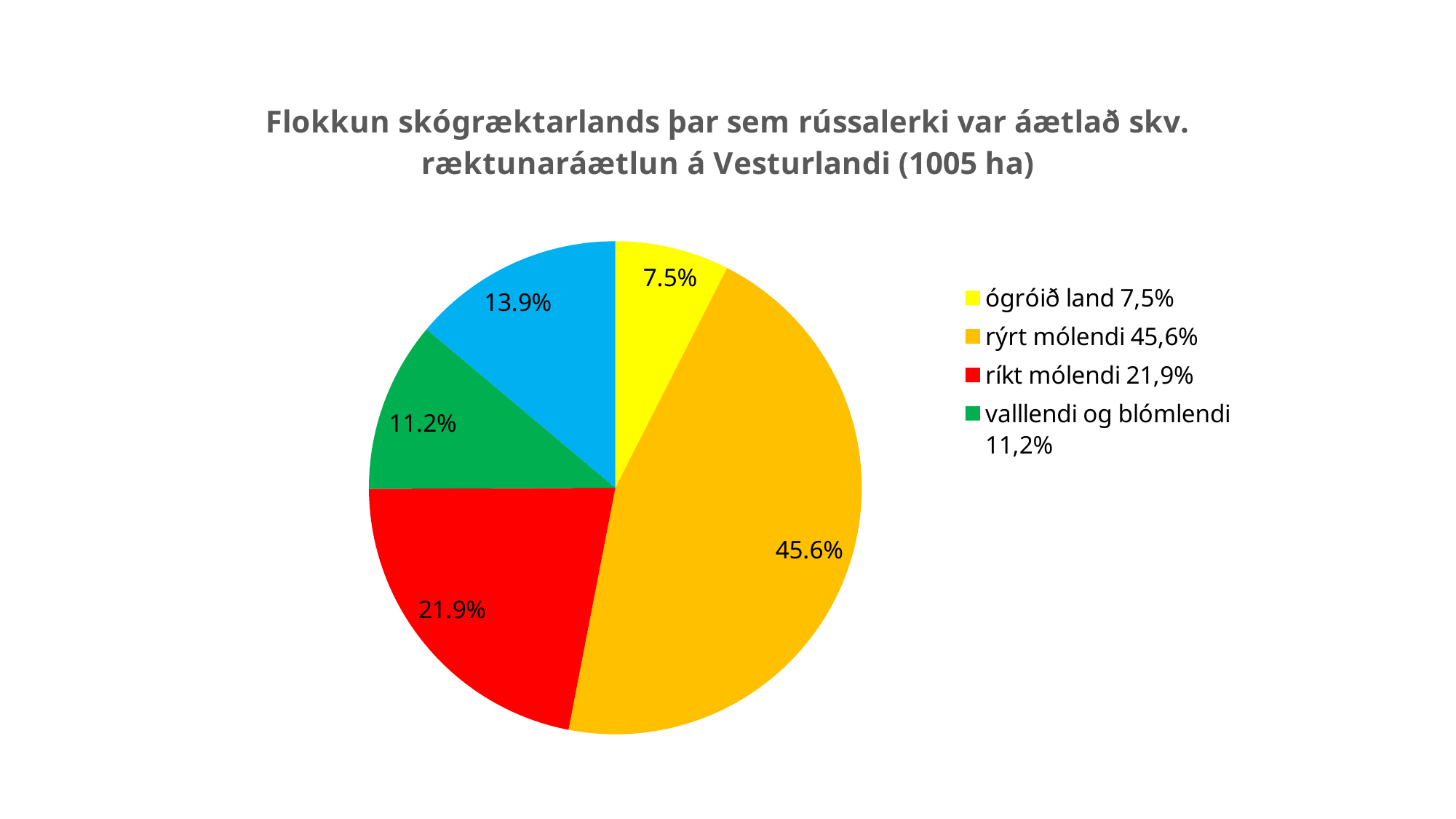
What share of the pie does "ríkt mólendi" have? 21.9% What is the difference in percentage points between "rýrt mólendi" and "ríkt mólendi"? 23.7 How many entries does the legend list? 4 What share of the pie does "rýrt mólendi" have? 45.6% Which is larger, the slice for "ríkt mólendi" or the slice for "valllendi og blómlendi"? ríkt mólendi What kind of chart is shown on the slide? pie chart What share of the pie does "valllendi og blómlendi" have? 11.2% What share of the pie does "ógróið land" have? 7.5% Which category has the largest slice of the pie? rýrt mólendi Which category has the smallest slice of the pie? ógróið land How many slices does the pie chart have? 5 What colour is the slice for "ríkt mólendi"? red